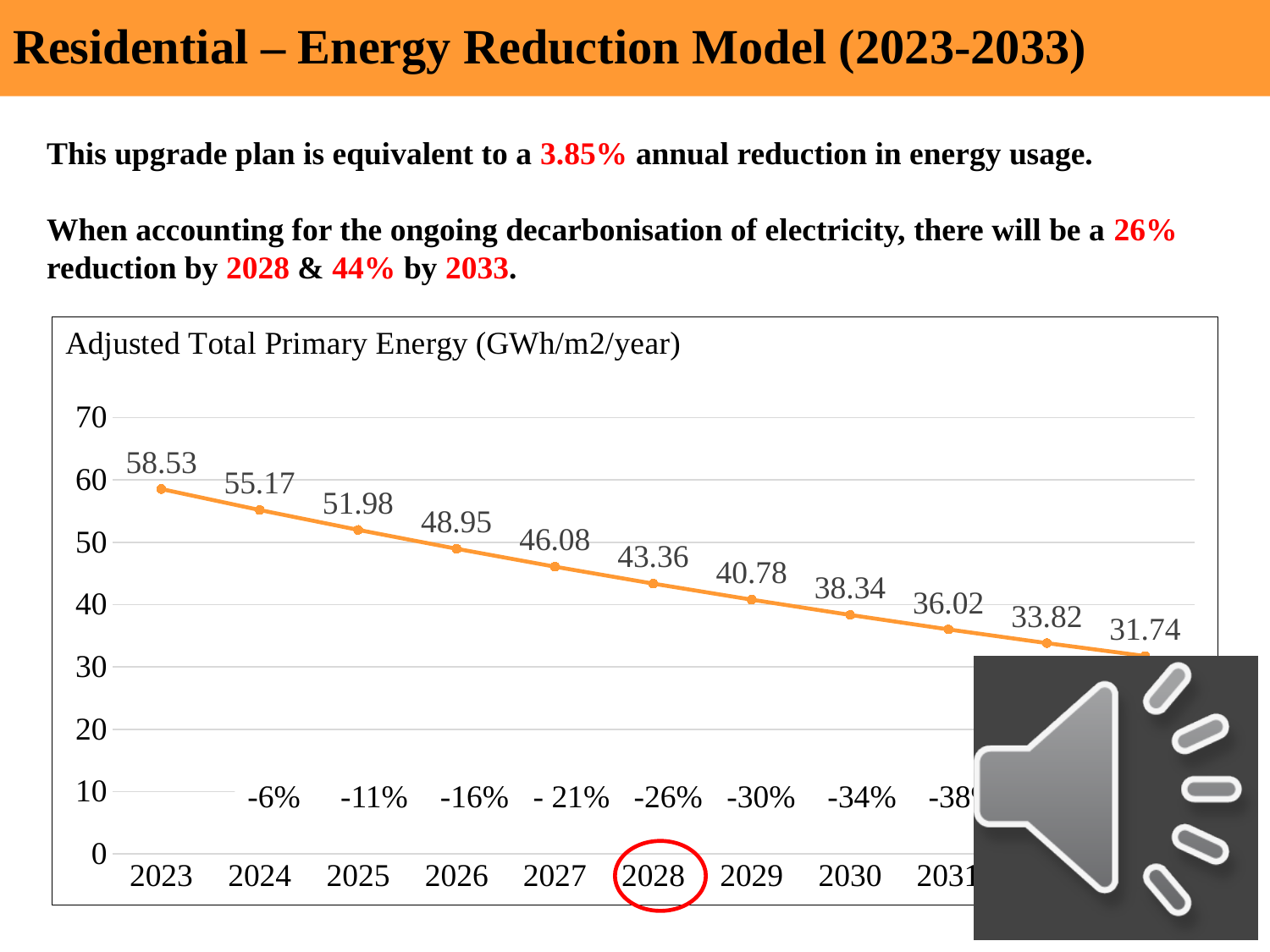
What is the Adjusted Total Primary Energy value for 2028? 43.36 What is the Adjusted Total Primary Energy value for 2030? 38.34 What is the difference between the values for 2023 and 2024? 3.36 Is the value for 2027 greater or less than 50? less What kind of chart is shown on the slide? line chart What is the difference between the values for 2028 and 2029? 2.58 Which year has the highest Adjusted Total Primary Energy value? 2023 Which year has a larger value, 2025 or 2029? 2025 What is the Adjusted Total Primary Energy value for 2023? 58.53 Do the values rise or fall from 2023 onwards along the x axis? fall What is the lowest value plotted on the chart? 31.74 What percentage reduction label is shown for 2028? -26%